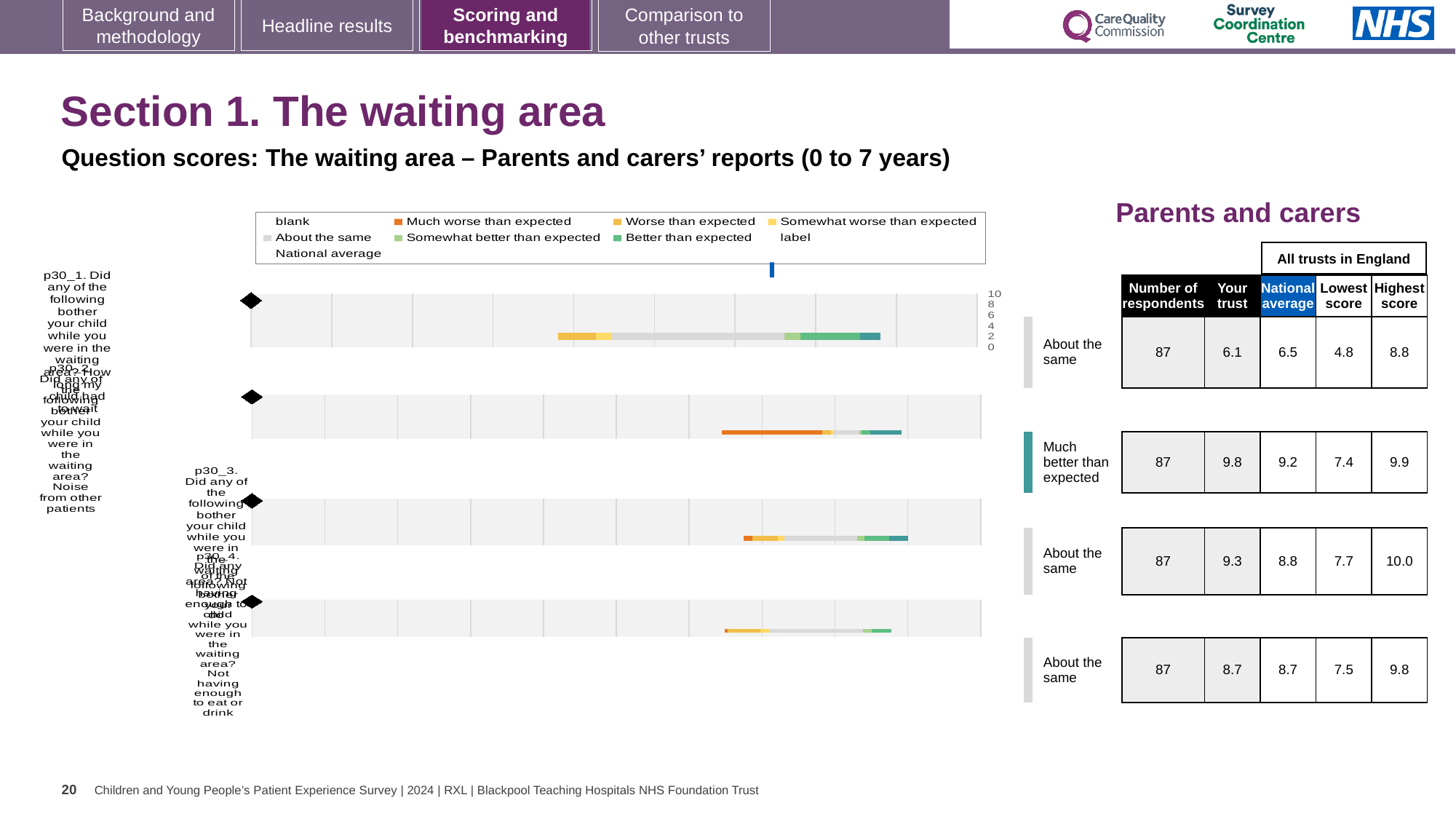
What kind of chart is shown on the slide? bar chart What is the 'Your trust' score for the first row, p30_1 (Noise from other patients)? 6.1 How many question rows (bars) does the chart show? 4 What is the 'Your trust' score for the second row, p30_2 (How long my child had to wait)? 9.8 Which question row has the lowest 'Your trust' score? p30_1 (Noise from other patients) What is the highest score across all trusts in England for p30_3 (Not having enough to do)? 10.0 What benchmark category is shown for p30_2 (How long my child had to wait)? Much better than expected What is the lowest score across all trusts in England for p30_2 (How long my child had to wait)? 7.4 What is the difference between the national average and the 'Your trust' score for p30_1 (Noise from other patients)? 0.4 What is the national average for the third row, p30_3 (Not having enough to do)? 8.8 For p30_3 (Not having enough to do), which is larger: the 'Your trust' score or the national average? Your trust Which question row has the highest 'Your trust' score? p30_2 (How long my child had to wait)